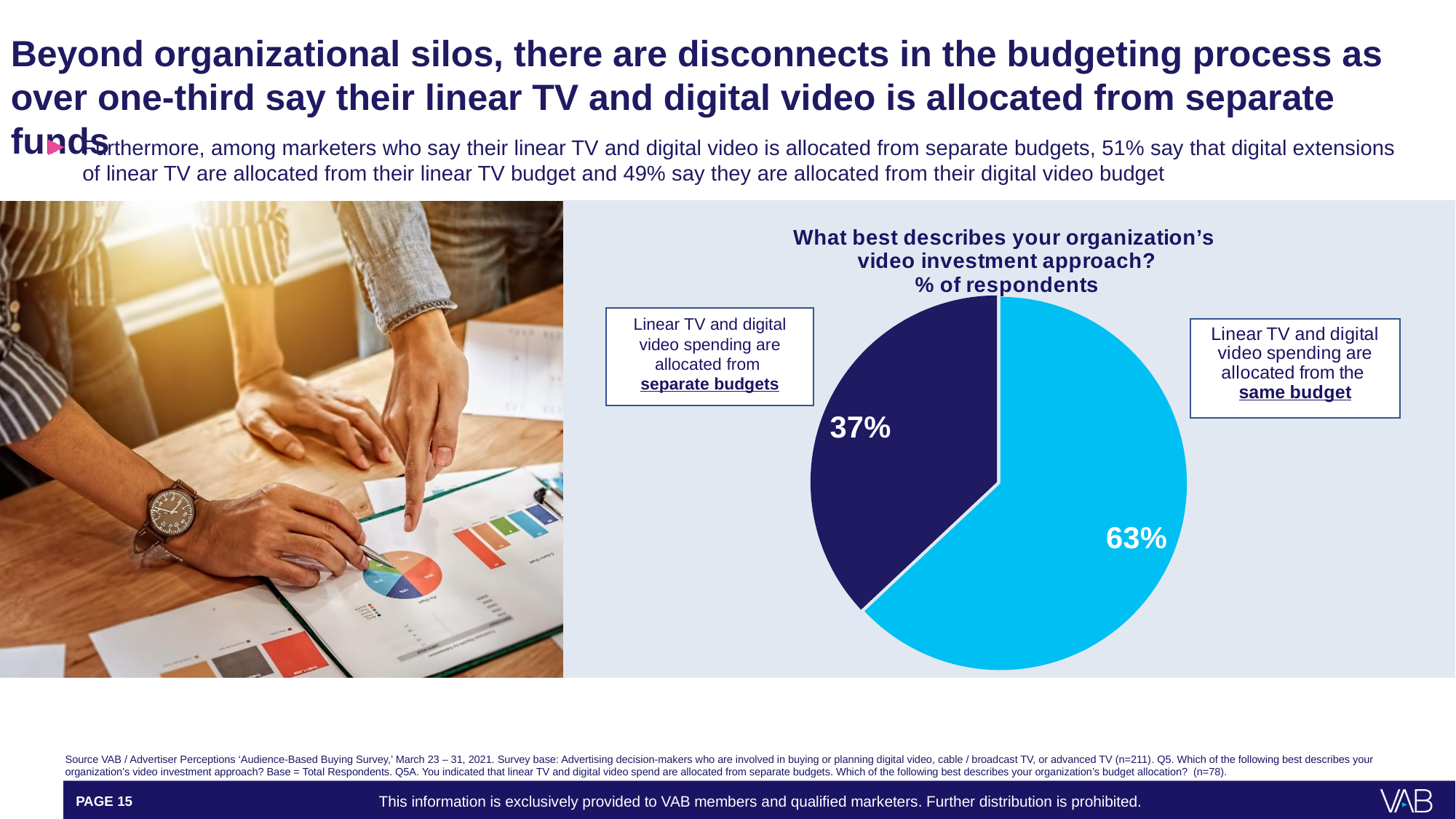
What is the difference in percentage points between the same budget share and the separate budgets share? 26 What type of chart is shown on the slide? Pie chart Which response has the larger share of respondents: separate budgets or the same budget? Same budget Is the share for separate budgets larger or smaller than the share for the same budget? Smaller What percentage of respondents say linear TV and digital video spending are allocated from the same budget? 63% What percentage of respondents say linear TV and digital video spending are allocated from separate budgets? 37% Do the two slices of the pie chart add up to 100%? Yes What colour is the slice representing the same budget? Light blue How many slices does the pie chart have? 2 What is the title of the chart? What best describes your organization's video investment approach? % of respondents Which response has the smaller share of respondents? Separate budgets